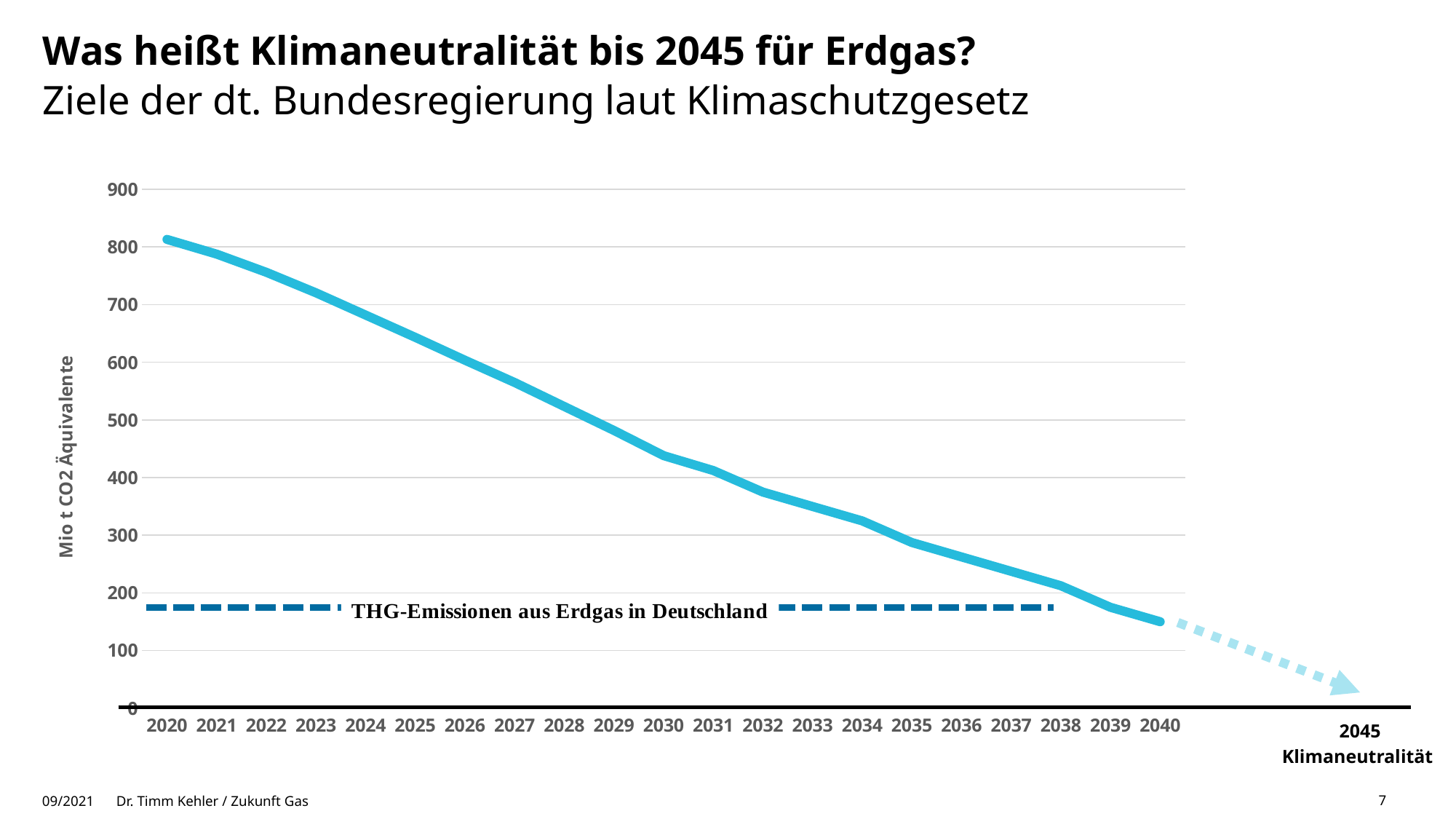
What is the title of the y axis? Mio t CO2 Äquivalente Do the plotted values rise or fall from 2020 to 2040? fall Is the value for 2020 greater or less than 700? greater Which year has the lowest plotted value on the solid line? 2040 How many years are labelled on the x axis? 21 What kind of chart is shown on the slide? line chart Is the value for 2040 greater or less than 200? less Is the value for 2025 greater or less than 600? greater What label is written on the dashed horizontal line? THG-Emissionen aus Erdgas in Deutschland Which year has the highest plotted value? 2020 Which year has the larger value, 2024 or 2034? 2024